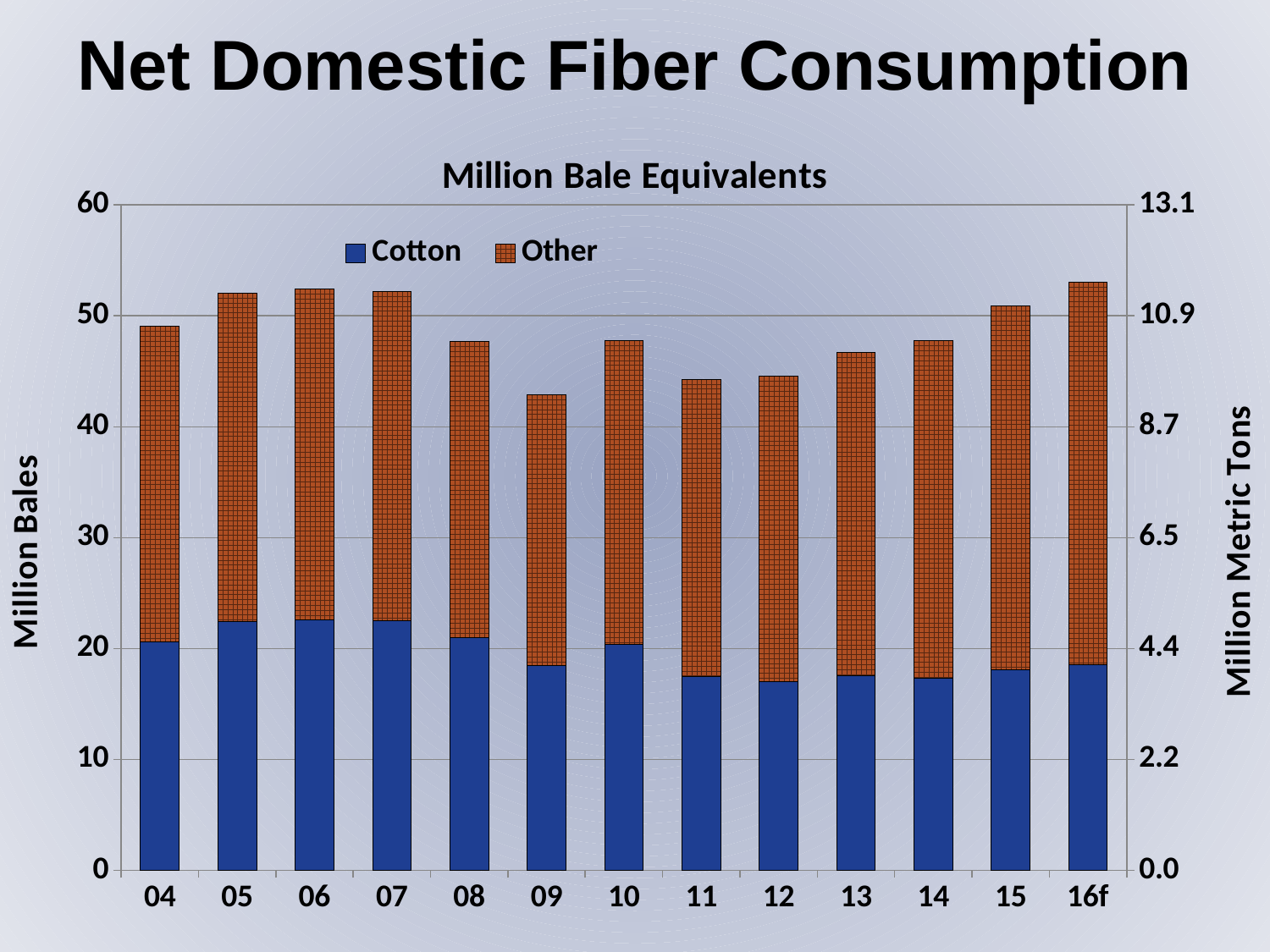
Is the Cotton value for 12 greater or less than 20 million bales? less Which year has the lowest total bar? 09 Is the total bar height for 11 greater or less than 50 million bales? less How many years (categories) are shown on the x axis? 13 What is the label of the left vertical axis? Million Bales Is the Cotton value for 06 greater or less than 20 million bales? greater Do the total bars rise or fall from 12 to 16f? rise What kind of chart is shown on the slide? stacked bar chart What are the two series named in the legend? Cotton and Other Which has the larger total bar, 05 or 08? 05 How many series does the legend list? 2